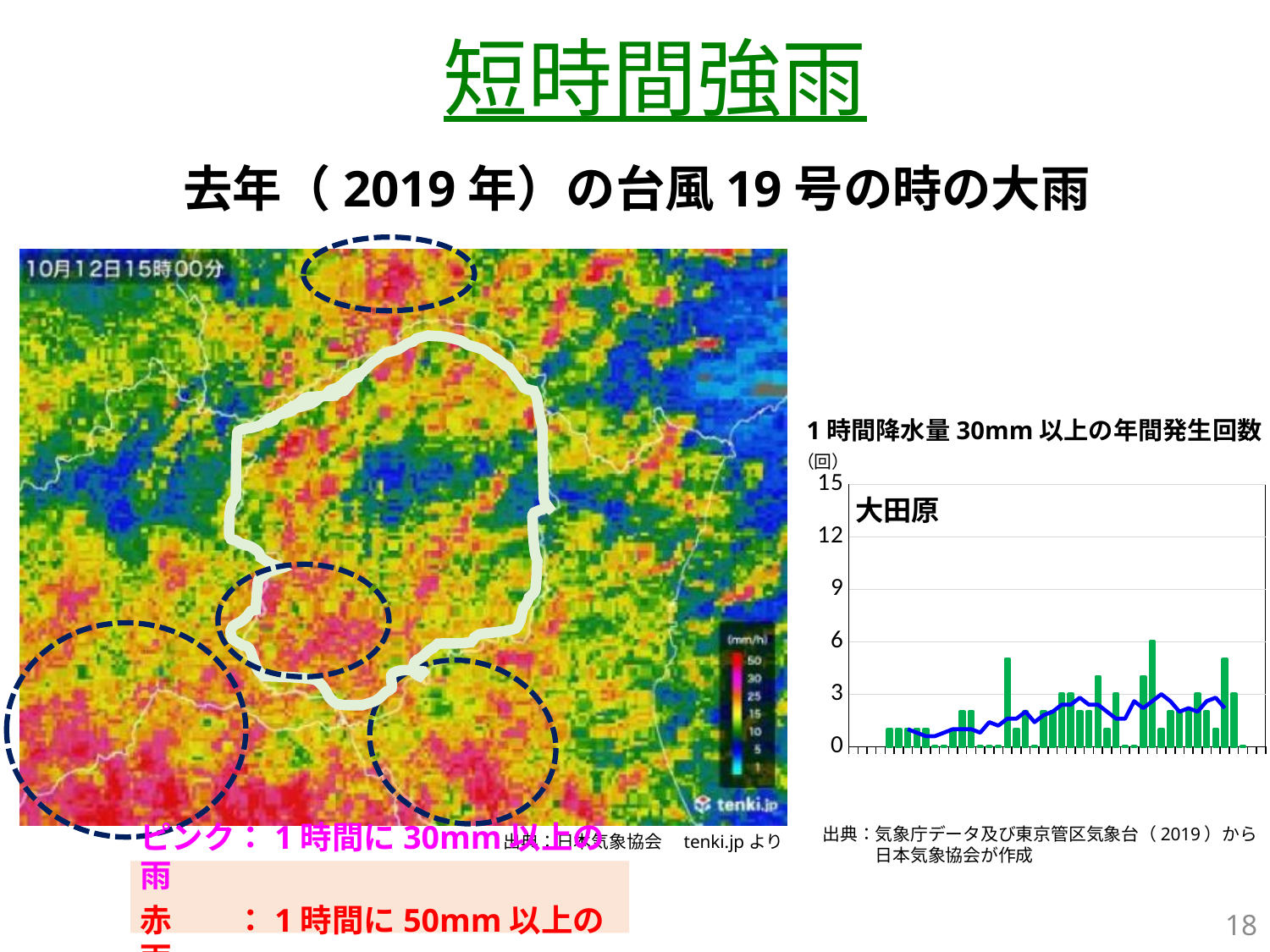
In the bar chart on the right, is the value of the leftmost bar greater or less than 3? less In the bar chart on the right, is the value of the tallest bar greater or less than 9? less What kind of chart is shown on the right side of the slide under the heading 1時間降水量30mm以上の年間発生回数? combination bar and line chart In the bar chart on the right, is the value of the rightmost bar greater or less than 6? less What is the title of the chart on the right side of the slide? 1時間降水量30mm以上の年間発生回数 Which location name is printed inside the plot area of the bar chart on the right? 大田原 In the bar chart on the right, do the bar values generally rise or fall from left to right along the x axis? rise